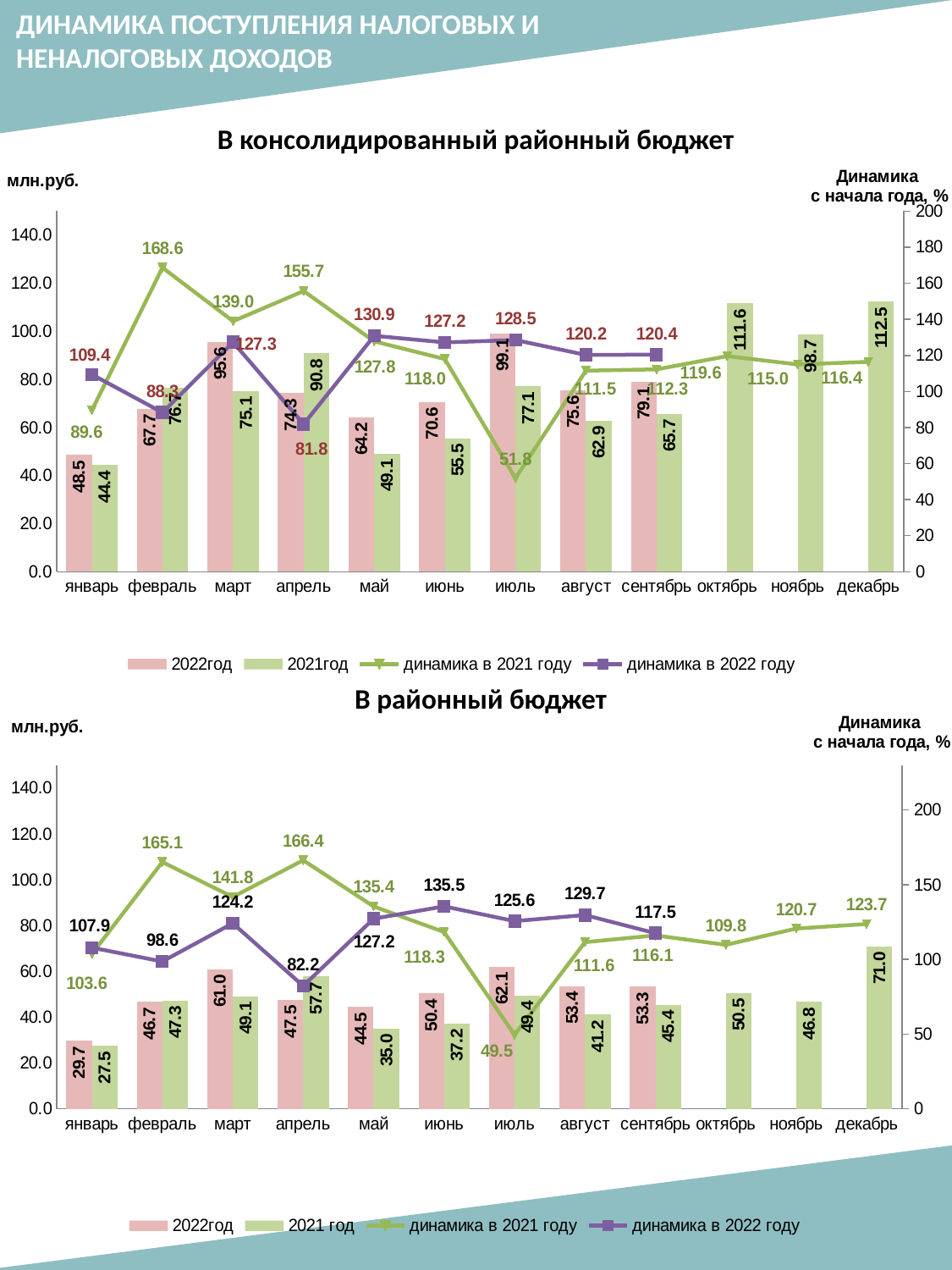
In the chart 'В консолидированный районный бюджет', which month has the lowest value on the 'динамика в 2021 году' line? июль In the chart 'В районный бюджет', how many months are shown on the x axis? 12 In the chart 'В консолидированный районный бюджет', what is the value of the 2021год bar for декабрь? 112.5 In the chart 'В районный бюджет', which month has the highest 2021 год bar? декабрь In the chart 'В консолидированный районный бюджет', how many series does the legend list? 4 In the chart 'В консолидированный районный бюджет', which month has the highest value on the 'динамика в 2021 году' line? февраль In the chart 'В районный бюджет', what is the value of the 'динамика в 2022 году' line for июнь? 135.5 What type of chart is 'В районный бюджет'? Combined bar and line chart In the chart 'В консолидированный районный бюджет', what is the value of the 2022год bar for июль? 99.1 In the chart 'В районный бюджет', which is larger for апрель: the 2022год bar or the 2021 год bar? 2021 год In the chart 'В районный бюджет', what is the difference between the 'динамика в 2021 году' values for апрель and июль? 116.9 In the chart 'В консолидированный районный бюджет', what is the difference between the 2022год and 2021год bars for май? 15.1